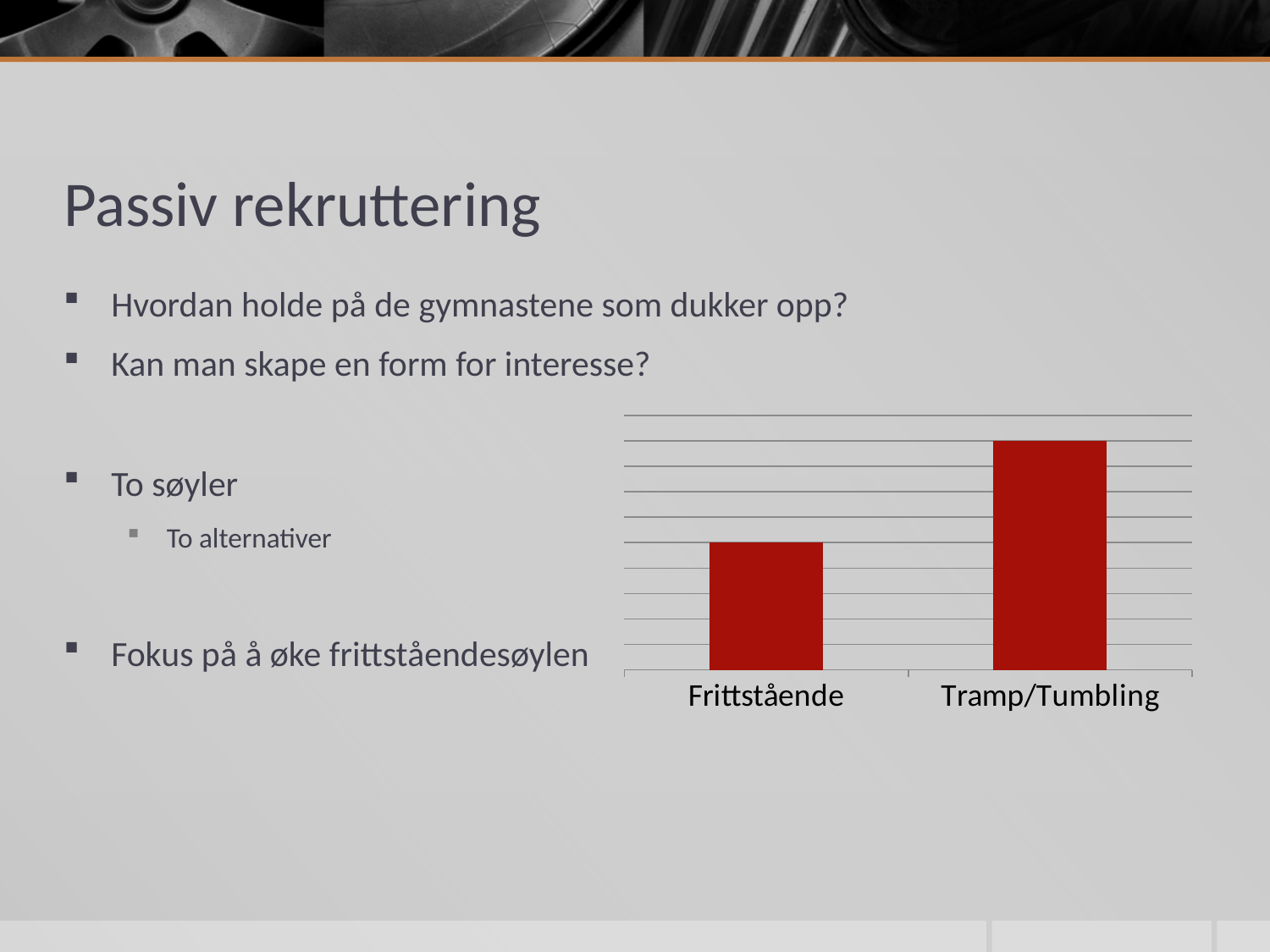
Which category has the highest bar in the chart? Tramp/Tumbling What are the two category labels on the x axis of the chart? Frittstående and Tramp/Tumbling Which category has the lowest bar in the chart? Frittstående Which is larger in the chart, the bar for Frittstående or the bar for Tramp/Tumbling? Tramp/Tumbling What colour are the bars in the chart? red How many categories are plotted in the chart? 2 What kind of chart is shown on the slide? bar chart